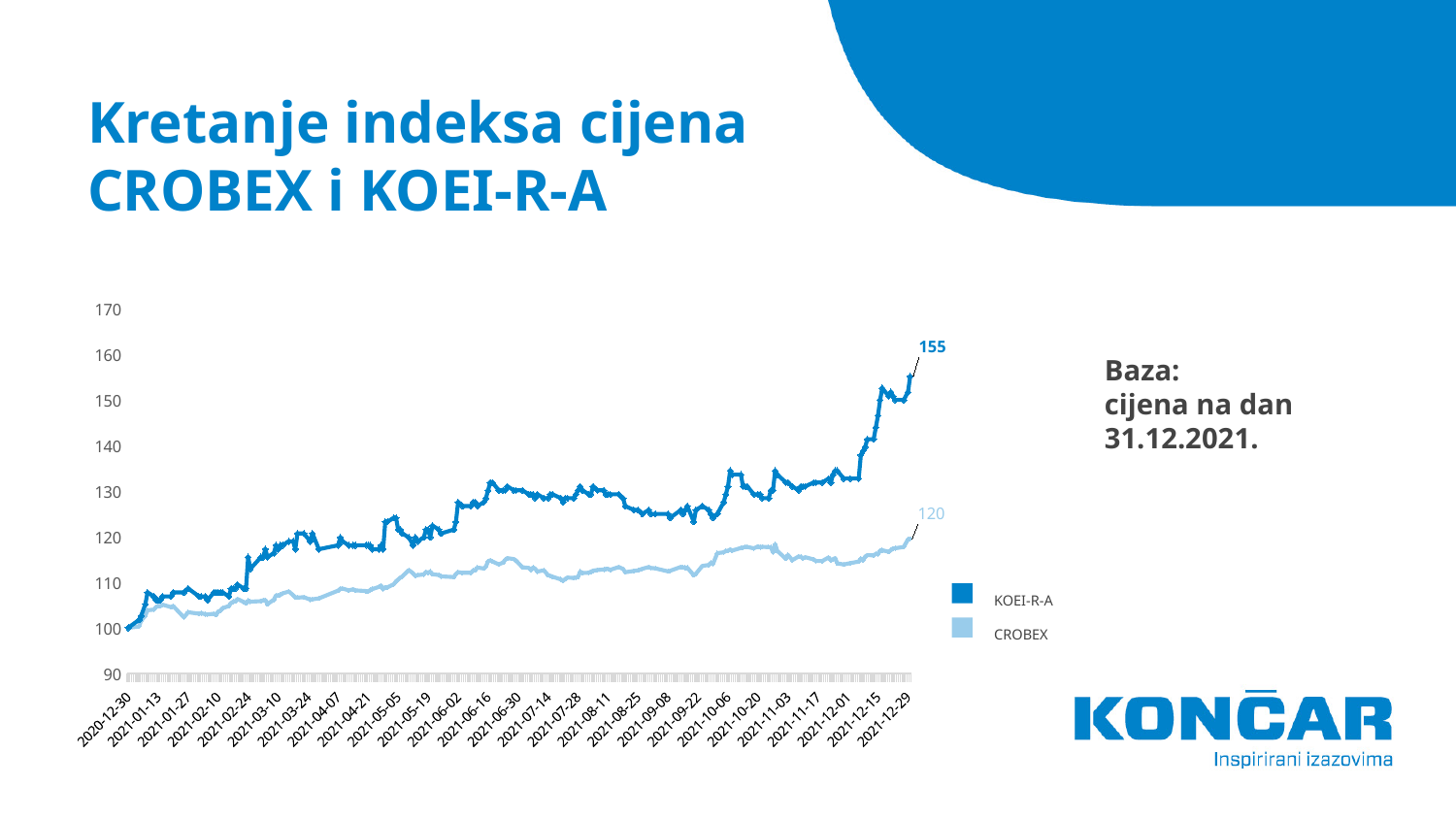
Which series reaches the highest value on the chart? KOEI-R-A What is the difference between the final labelled values of KOEI-R-A and CROBEX? 35 What kind of chart is shown on the slide? line chart What is the final labelled value of the CROBEX series? 120 What is the title of the chart on the slide? Kretanje indeksa cijena CROBEX i KOEI-R-A Which series is drawn in the lighter blue colour? CROBEX Does the KOEI-R-A series rise or fall overall from 2020-12-30 to 2021-12-29? rise Is the value for KOEI-R-A around 2021-06-16 greater or less than 120? greater What is the final labelled value of the KOEI-R-A series? 155 Is the value for CROBEX around 2021-06-16 greater or less than 120? less Which series ends at a higher value, KOEI-R-A or CROBEX? KOEI-R-A How many series does the legend list? 2